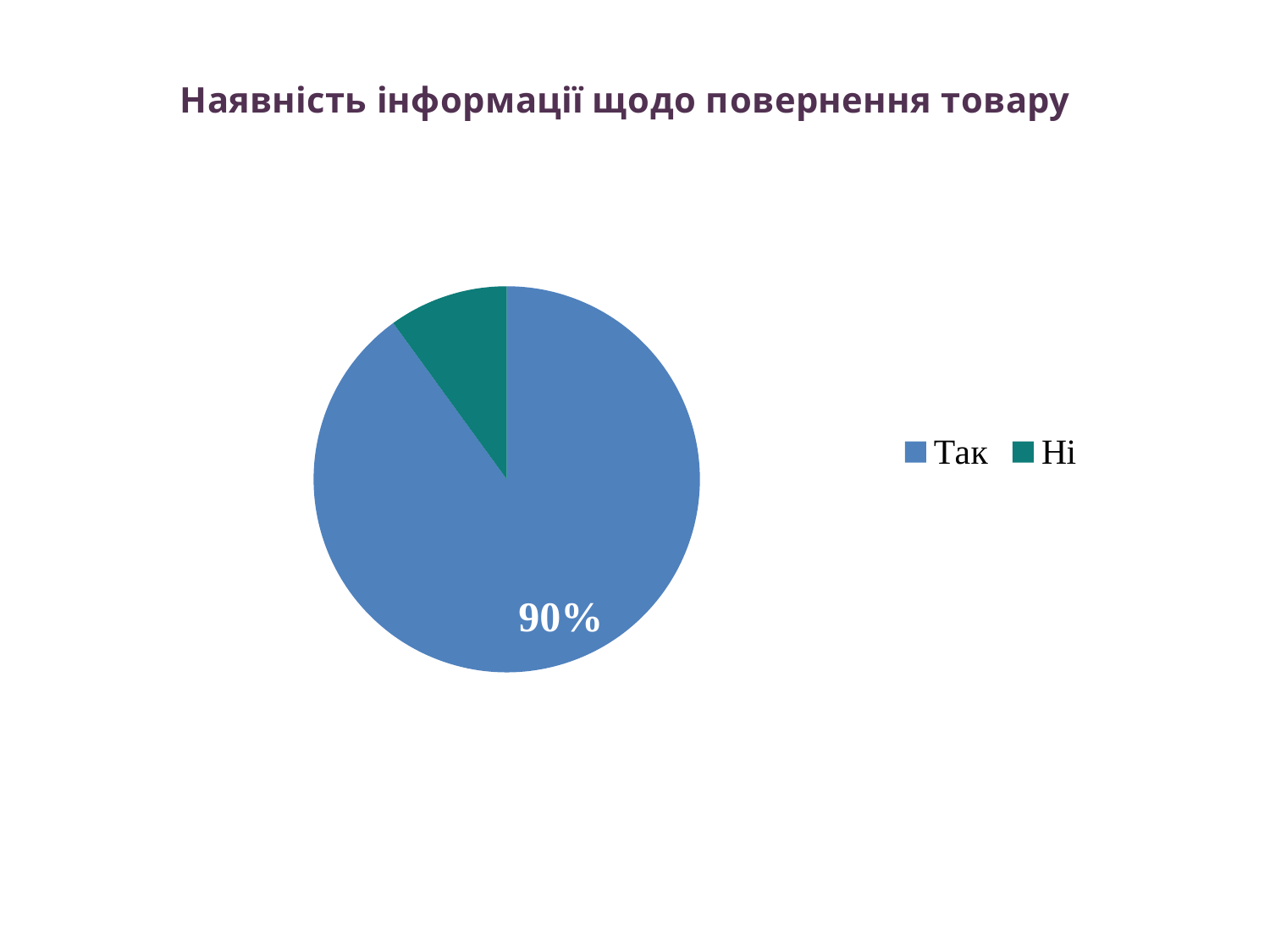
Which category has the largest slice of the pie? Так How many categories does the pie chart have? 2 Which slice is larger, "Так" or "Ні"? Так How many entries does the legend list? 2 What colour is the "Ні" slice in the pie chart? green Which category has the smallest slice of the pie? Ні What share of the pie does the "Так" slice represent? 90% What kind of chart is shown on the slide? pie chart What is the title of the chart? Наявність інформації щодо повернення товару